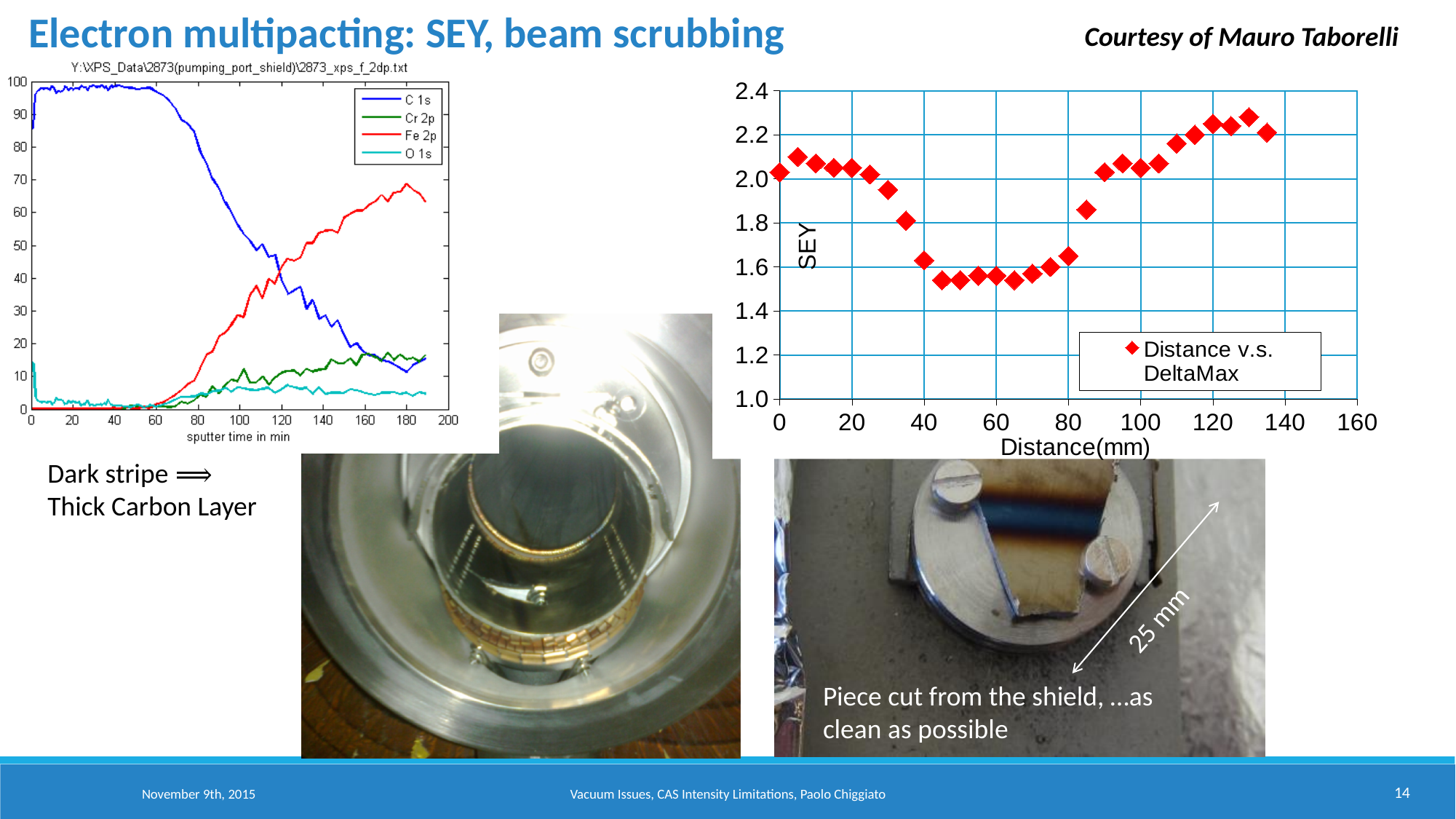
In the SEY chart on the right, is the SEY value at 130 mm greater or less than 2.2? greater In the SEY chart on the right, does SEY rise or fall as distance increases from 80 mm to 130 mm? rise In the SEY chart on the right, how many series does the legend list? 1 In the SEY chart on the right, is the SEY value at 50 mm greater or less than 1.6? less In the XPS line chart on the left, does the C 1s curve rise or fall as sputter time increases from 60 to 180 min? fall In the XPS line chart on the left, is the Fe 2p value at 180 min sputter time greater or less than 60? greater In the SEY chart on the right, does SEY rise or fall as distance increases from 0 mm to 50 mm? fall In the SEY chart on the right, which is larger: the SEY at 130 mm or the SEY at 50 mm? 130 mm What kind of chart is the chart on the right with SEY on the y axis? scatter chart In the SEY chart on the right, what is the label of the x axis? Distance(mm) How many series does the legend of the XPS line chart on the left list? 4